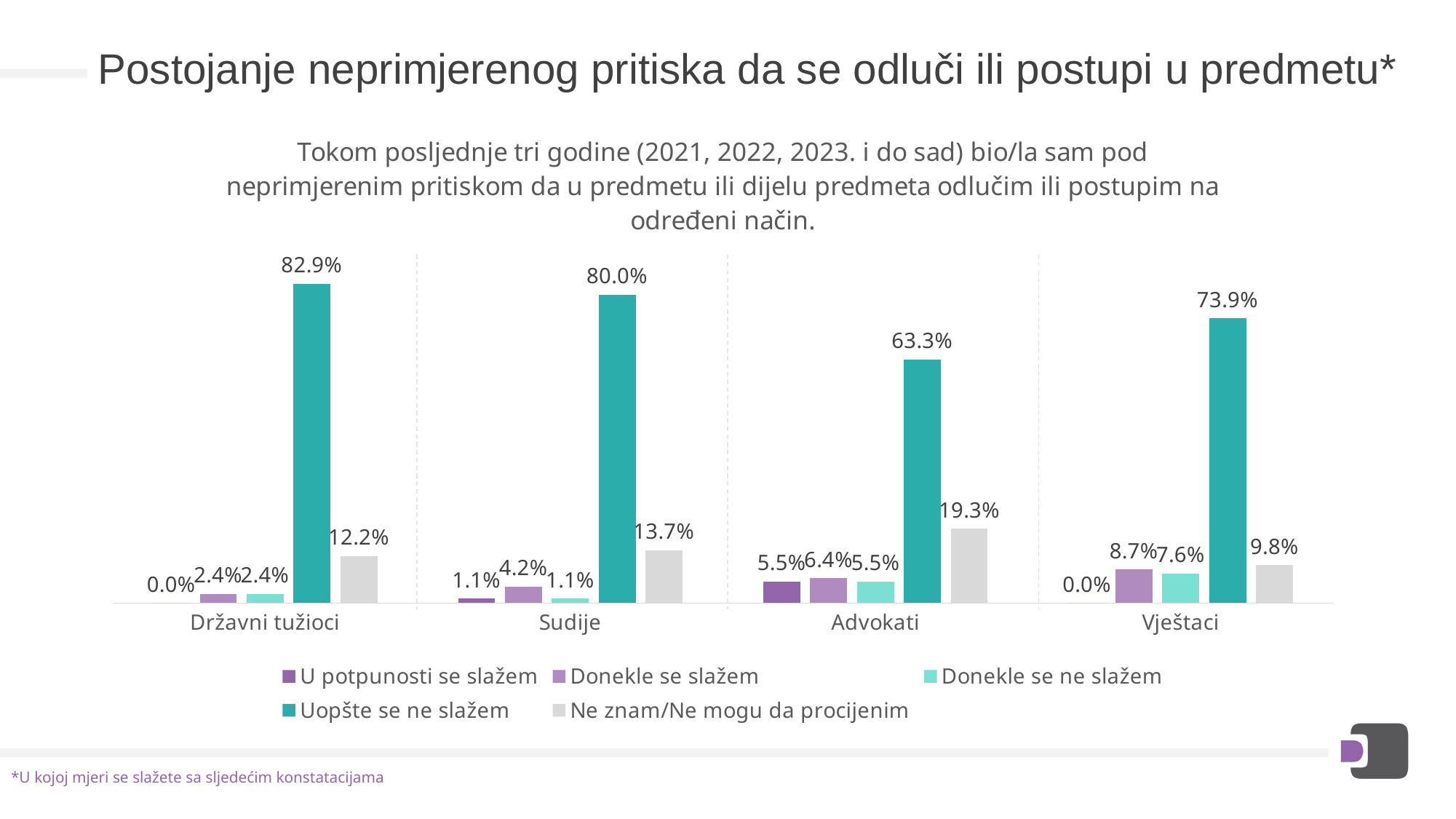
Which category has the lowest value for "Uopšte se ne slažem"? Advokati How many categories are shown on the x axis? 4 Which is larger: "Ne znam/Ne mogu da procijenim" for Sudije or for Vještaci? Sudije What is the value of "Ne znam/Ne mogu da procijenim" for Advokati? 19.3% Which category has the highest value for "Uopšte se ne slažem"? Državni tužioci What is the value of "Uopšte se ne slažem" for Državni tužioci? 82.9% What is the difference between the "Uopšte se ne slažem" values for Sudije and Advokati? 16.7% What is the value of "U potpunosti se slažem" for Sudije? 1.1% What is the value of "Donekle se slažem" for Vještaci? 8.7% Which category has the highest value for "U potpunosti se slažem"? Advokati How many series does the legend list? 5 What kind of chart is shown on the slide? Bar chart